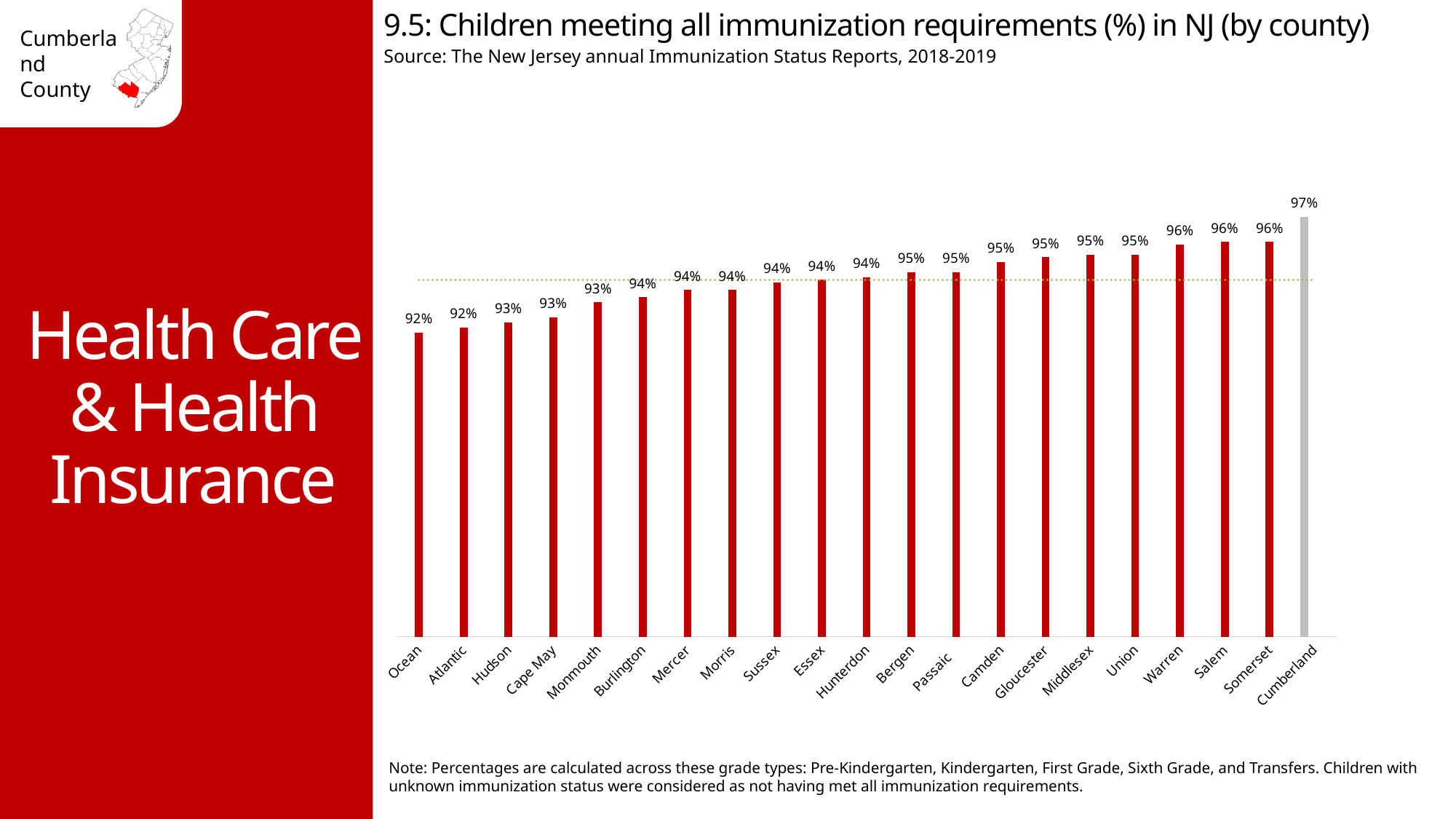
What is the value shown for Ocean County? 92% How many counties are shown on the chart? 21 What type of chart is used on this slide? Bar chart What is the difference in percentage points between Somerset and Monmouth counties? 3 percentage points What is the difference in percentage points between Cumberland and Ocean counties? 5 percentage points What percentage is shown for Bergen County? 95% What is the value shown for Warren County? 96% What percentage of children in Cumberland County met all immunization requirements? 97% Which county's bar is shown in grey rather than red? Cumberland Which county has a higher value, Hudson or Warren? Warren Do the values rise or fall moving from left to right across the counties? Rise Which county has the highest percentage of children meeting all immunization requirements? Cumberland